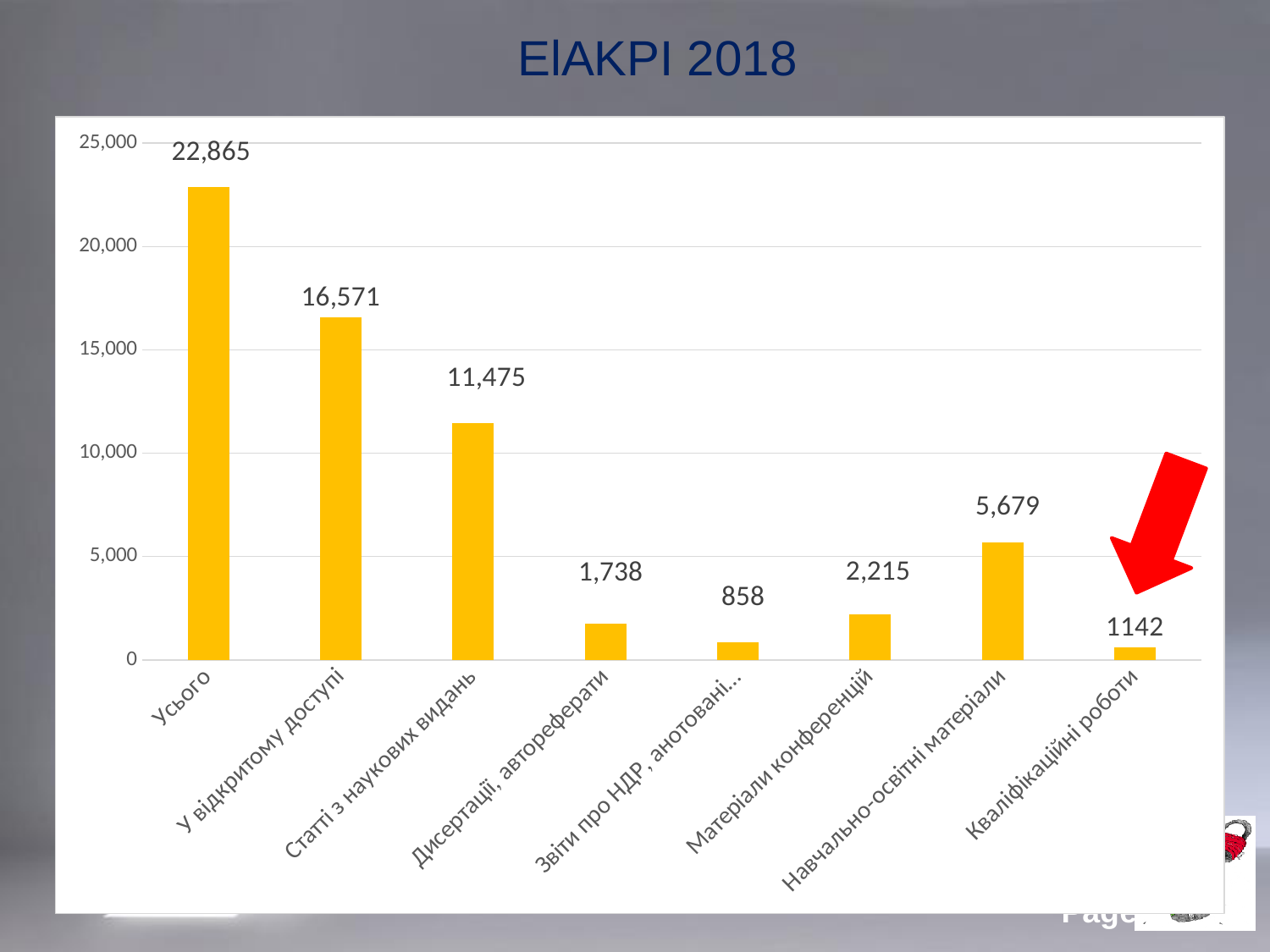
What is the title of the slide? ElAKPI 2018 What is the difference between the values for Усього and У відкритому доступі? 6,294 What is the value for Навчально-освітні матеріали? 5,679 Is the value for Статті з наукових видань greater or less than 10,000? greater What kind of chart is shown on the slide? bar chart How many categories are shown on the x axis? 8 Which category has the highest value? Усього Which is larger, the value for Матеріали конференцій or the value for Дисертації, автореферати? Матеріали конференцій What is the value for Усього? 22,865 What is the value for Кваліфікаційні роботи? 1142 What is the value for У відкритому доступі? 16,571